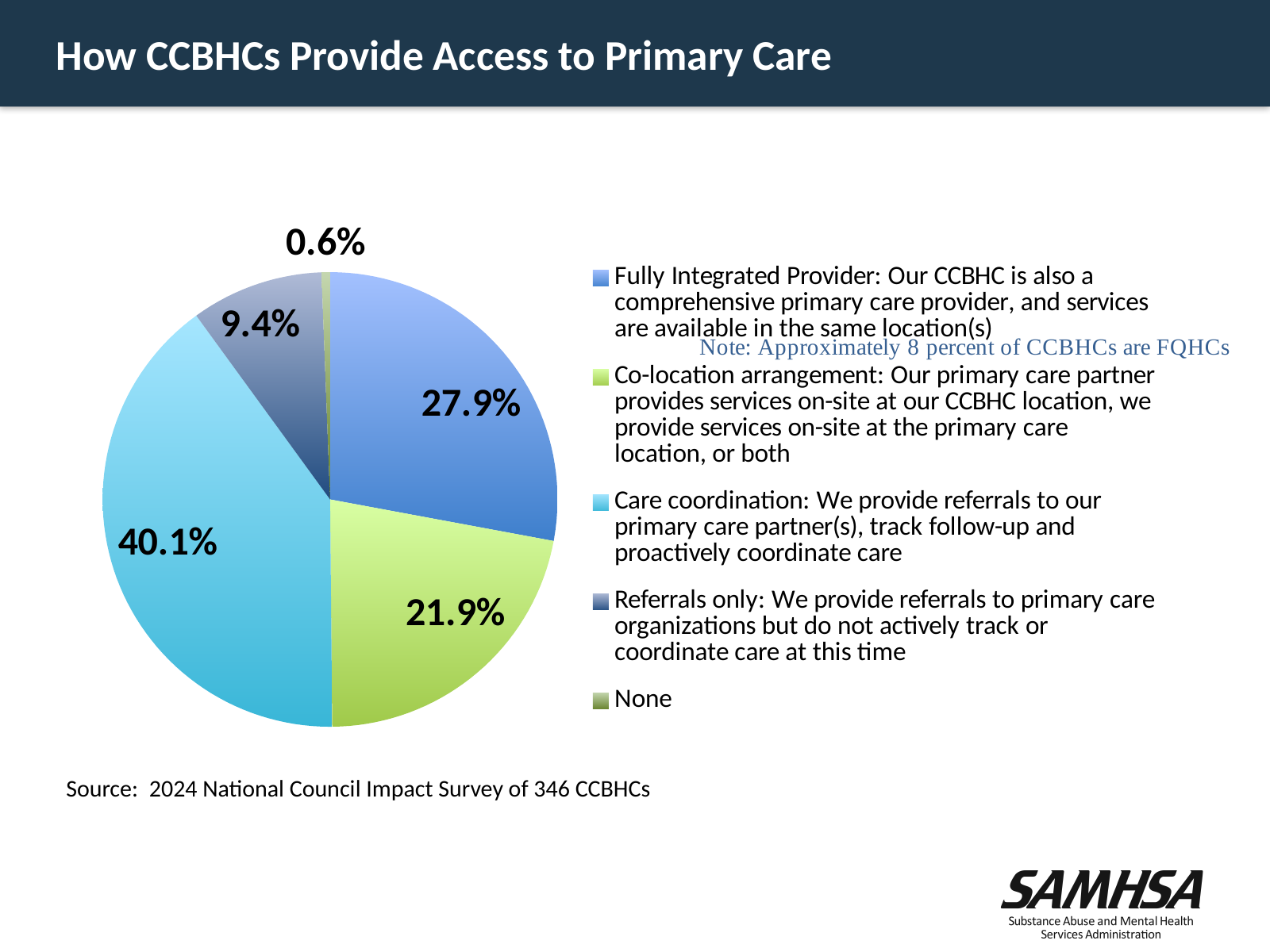
What kind of chart is shown on the slide? Pie chart What is the title of the slide containing the pie chart? How CCBHCs Provide Access to Primary Care Which is larger: the Co-location arrangement share or the Referrals only share? Co-location arrangement How many percentage points larger is the Care coordination share than the Fully Integrated Provider share? 12.2 What percentage of CCBHCs report None for primary care access? 0.6% Which category has the smallest share of the pie? None Which category has the largest share of the pie? Care coordination What percentage of CCBHCs have a Co-location arrangement? 21.9% How many categories does the pie chart have? 5 What percentage of CCBHCs are a Fully Integrated Provider of primary care? 27.9% What percentage of CCBHCs provide Referrals only? 9.4% What share of CCBHCs report a Care coordination arrangement for primary care access? 40.1%